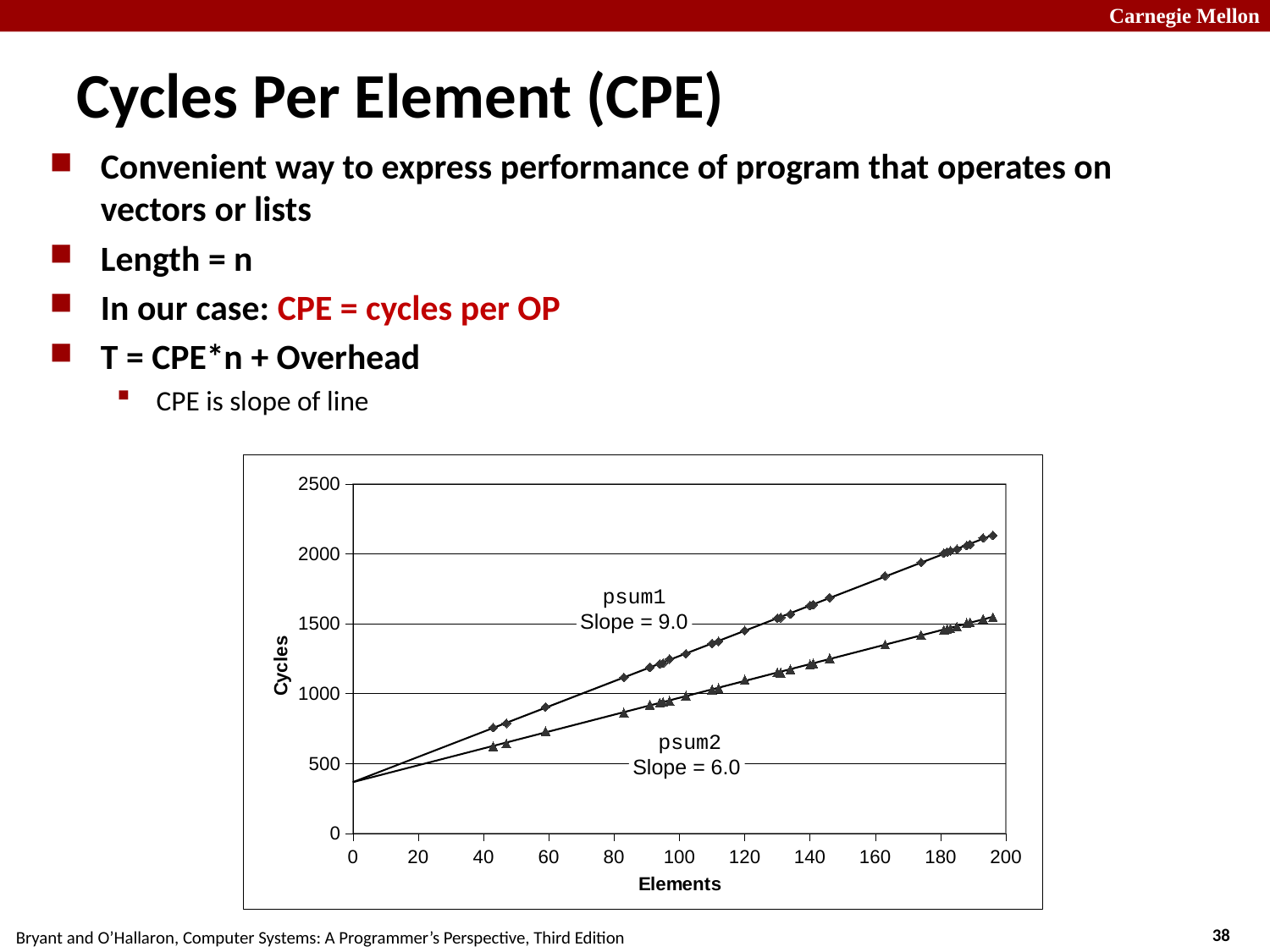
At around 100 elements, is the value for psum2 greater or less than 1500 cycles? less What is the slope of the psum1 line according to the chart annotation? 9.0 What is the label of the y axis? Cycles Which series has the steeper slope, psum1 or psum2? psum1 What is the label of the x axis? Elements Which series has higher cycle counts at 180 elements, psum1 or psum2? psum1 How many data series are plotted on the chart? 2 What is the slope of the psum2 line according to the chart annotation? 6.0 At around 195 elements, is the value for psum1 greater or less than 2000 cycles? greater Do the cycle counts rise or fall as the number of elements increases? Rise At around 195 elements, is the value for psum2 greater or less than 2000 cycles? less What kind of chart is shown on the slide? Scatter (line) chart